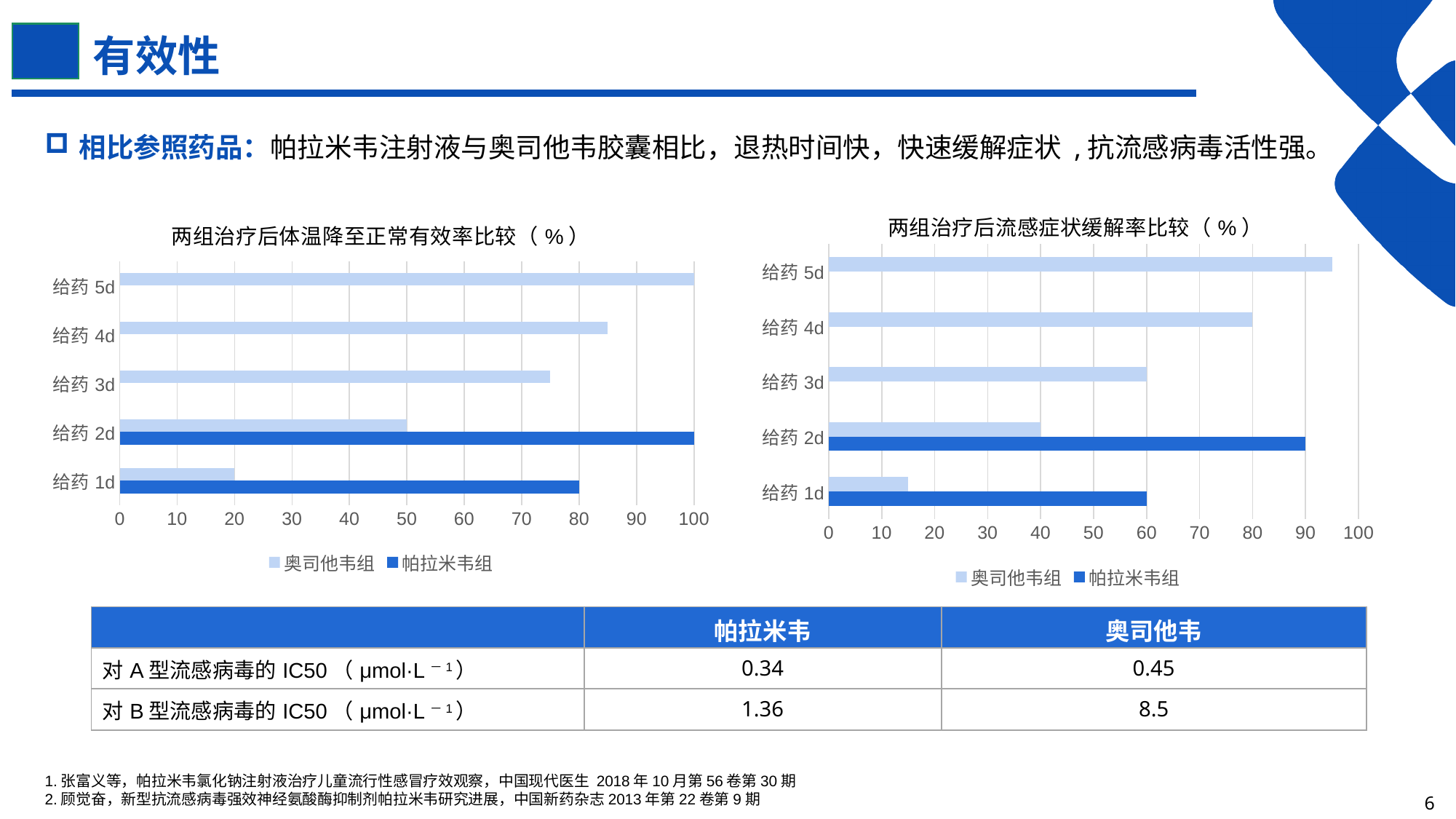
In the chart titled 两组治疗后流感症状缓解率比较（%）, how many categories are shown on the vertical axis? 5 In the chart titled 两组治疗后流感症状缓解率比较（%）, is the value for 奥司他韦组 at 给药 1d greater or less than 20? less In the chart titled 两组治疗后流感症状缓解率比较（%）, which is larger at 给药 1d: 奥司他韦组 or 帕拉米韦组? 帕拉米韦组 In the chart titled 两组治疗后流感症状缓解率比较（%）, what is the value for 帕拉米韦组 at 给药 2d? 90 In the chart titled 两组治疗后流感症状缓解率比较（%）, what is the value for 奥司他韦组 at 给药 3d? 60 In the chart titled 两组治疗后体温降至正常有效率比较（%）, what is the difference between 帕拉米韦组 and 奥司他韦组 at 给药 2d? 50 In the chart titled 两组治疗后体温降至正常有效率比较（%）, what is the value for 帕拉米韦组 at 给药 1d? 80 In the chart titled 两组治疗后体温降至正常有效率比较（%）, how many series does the legend list? 2 What kind of chart is the chart titled 两组治疗后体温降至正常有效率比较（%）? bar chart In the chart titled 两组治疗后体温降至正常有效率比较（%）, is the value for 奥司他韦组 at 给药 4d greater or less than 80? greater In the chart titled 两组治疗后体温降至正常有效率比较（%）, what is the value for 奥司他韦组 at 给药 5d? 100 In the chart titled 两组治疗后流感症状缓解率比较（%）, do the 奥司他韦组 values rise or fall from 给药 1d to 给药 5d? rise